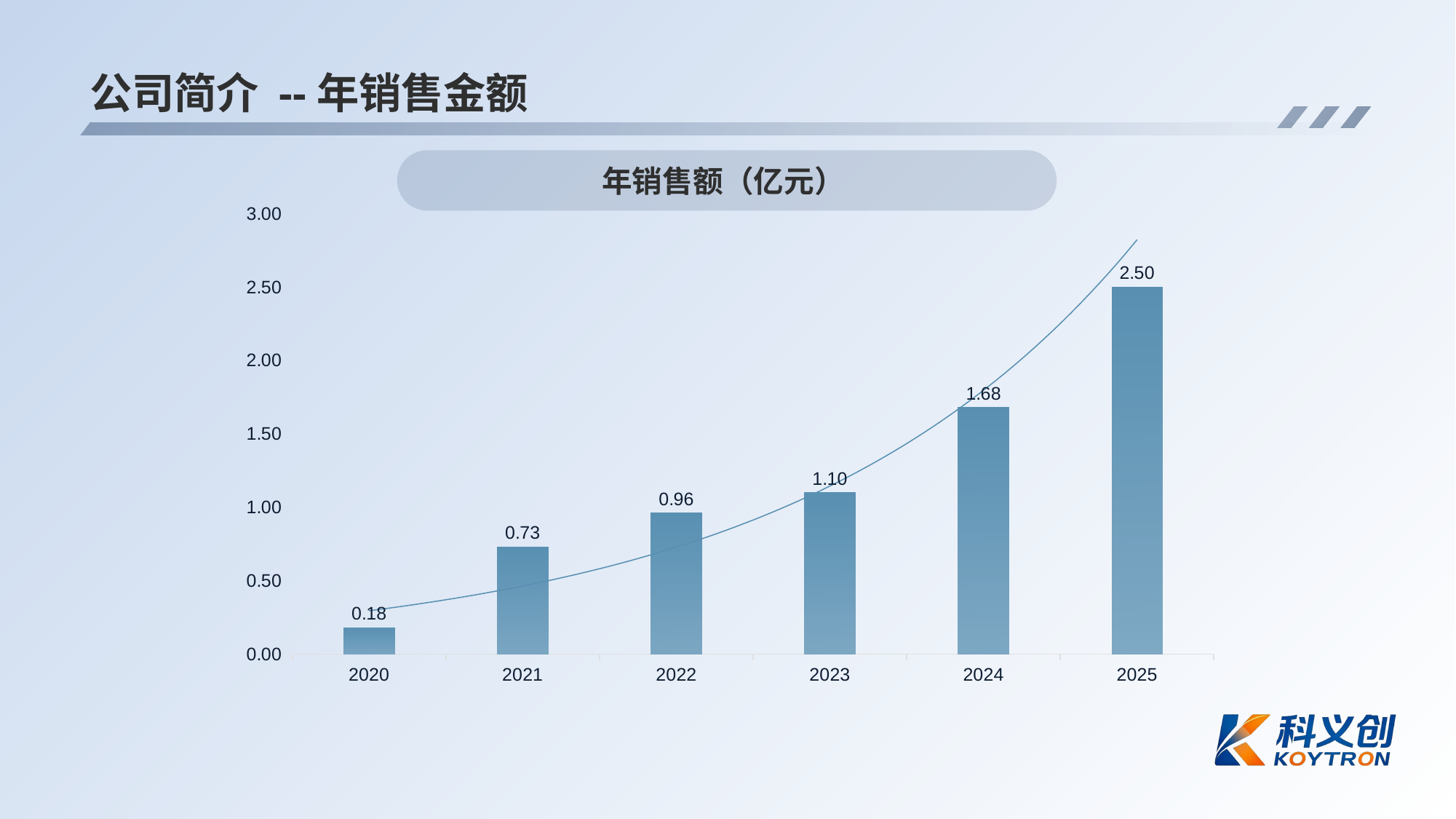
Which year has the lowest annual sales? 2020 What is the difference between the 2023 and 2021 values? 0.37 What is the difference between the 2025 and 2024 values? 0.82 What kind of chart is shown on the slide? bar chart Is the value for 2024 greater or less than 1.50? greater What is the annual sales value for 2022? 0.96 Which year has the highest annual sales? 2025 Do the values rise or fall from 2020 to 2025? rise What is the annual sales value for 2024? 1.68 Which is larger, the value for 2022 or the value for 2023? 2023 What is the annual sales value for 2020? 0.18 How many years are shown on the x axis? 6